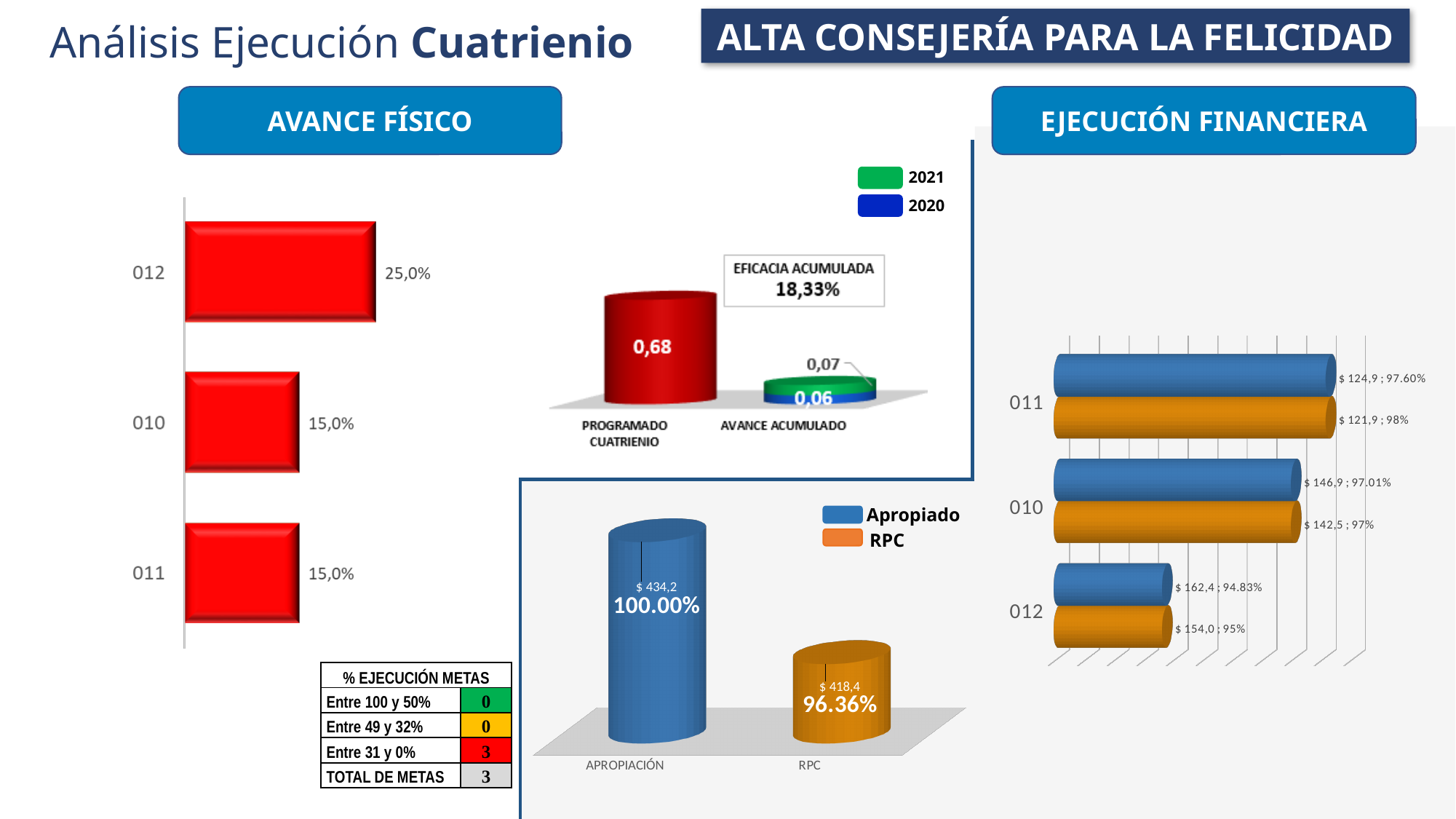
In the red horizontal bar chart under AVANCE FÍSICO, how many categories are shown? 3 In the red horizontal bar chart under AVANCE FÍSICO, what is the difference between the values for 012 and 010? 10,0% In the cylinder chart with PROGRAMADO CUATRIENIO and AVANCE ACUMULADO, what is the 2021 value for AVANCE ACUMULADO? 0,07 In the EJECUCIÓN FINANCIERA horizontal bar chart, what is the Apropiado label for category 010? $ 146,9 ; 97.01% In the cylinder chart with PROGRAMADO CUATRIENIO and AVANCE ACUMULADO, what is the value for PROGRAMADO CUATRIENIO? 0,68 What type of chart is shown under AVANCE FÍSICO on the left? bar chart In the red horizontal bar chart under AVANCE FÍSICO, which category has the highest value? 012 In the bottom-middle chart with APROPIACIÓN and RPC, what dollar value is shown for APROPIACIÓN? $ 434,2 In the bottom-middle chart with APROPIACIÓN and RPC, what percentage is shown for RPC? 96.36% In the cylinder chart with PROGRAMADO CUATRIENIO and AVANCE ACUMULADO, how many series does the legend list? 2 In the red horizontal bar chart under AVANCE FÍSICO, what is the value for category 012? 25,0%